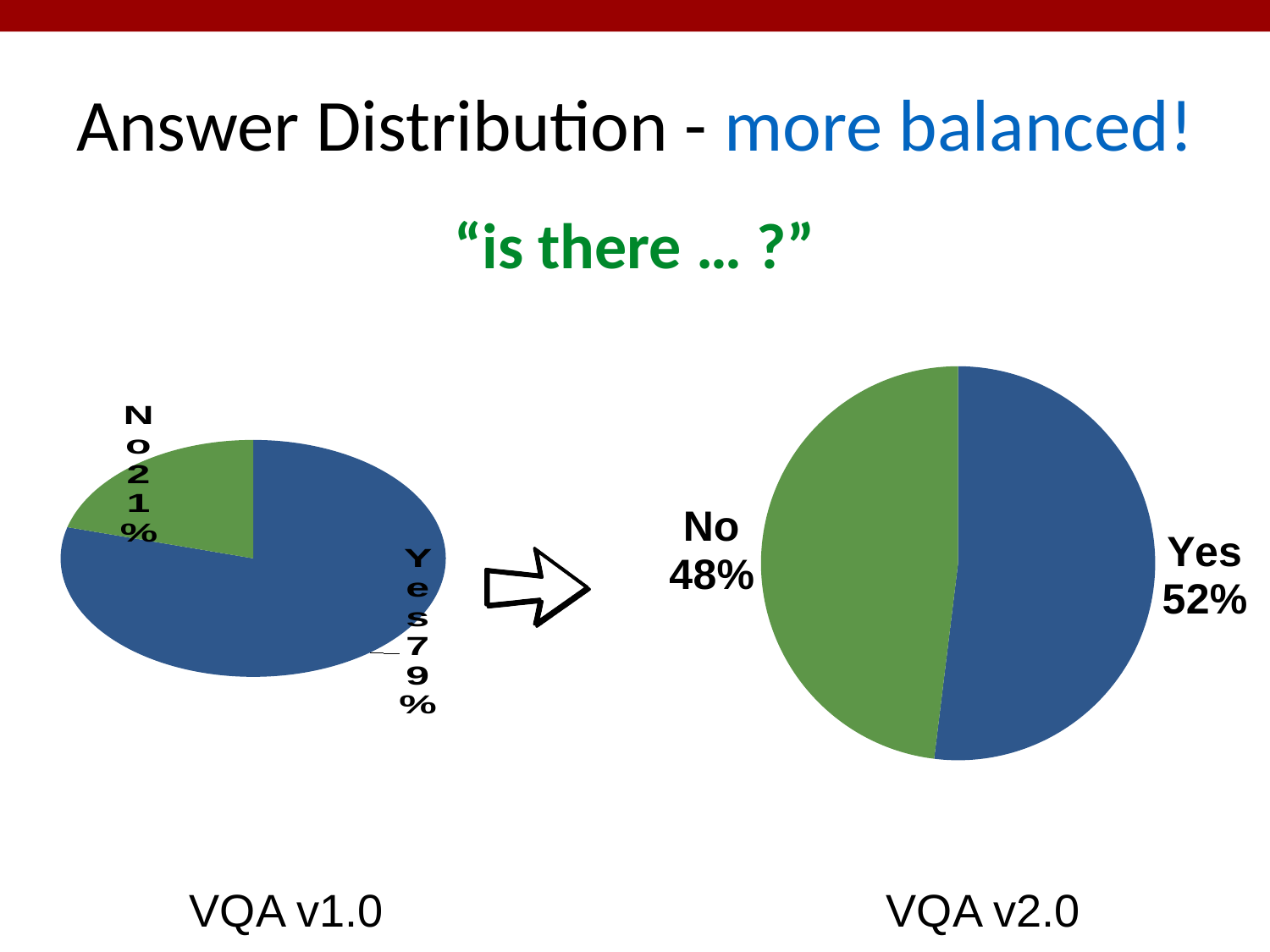
In the VQA v1.0 pie chart on the left, which answer has the largest slice? Yes In the VQA v2.0 pie chart on the right, which answer has the smallest slice? No What colour is the "Yes" slice in the VQA v2.0 pie chart on the right? Blue In the VQA v2.0 pie chart on the right, what share of answers is "No"? 48% In the VQA v2.0 pie chart on the right, what share of answers is "Yes"? 52% In the VQA v1.0 pie chart on the left, what share of answers is "Yes"? 79% How many slices does the VQA v2.0 pie chart on the right have? 2 In the VQA v2.0 pie chart on the right, what is the difference in percentage points between the Yes and No slices? 4 In the VQA v1.0 pie chart on the left, what is the difference in percentage points between the Yes and No slices? 58 What type of chart is used for the VQA v1.0 answer distribution on the left? Pie chart Is the "No" share larger in the VQA v1.0 chart or the VQA v2.0 chart? VQA v2.0 In the VQA v1.0 pie chart on the left, what share of answers is "No"? 21%